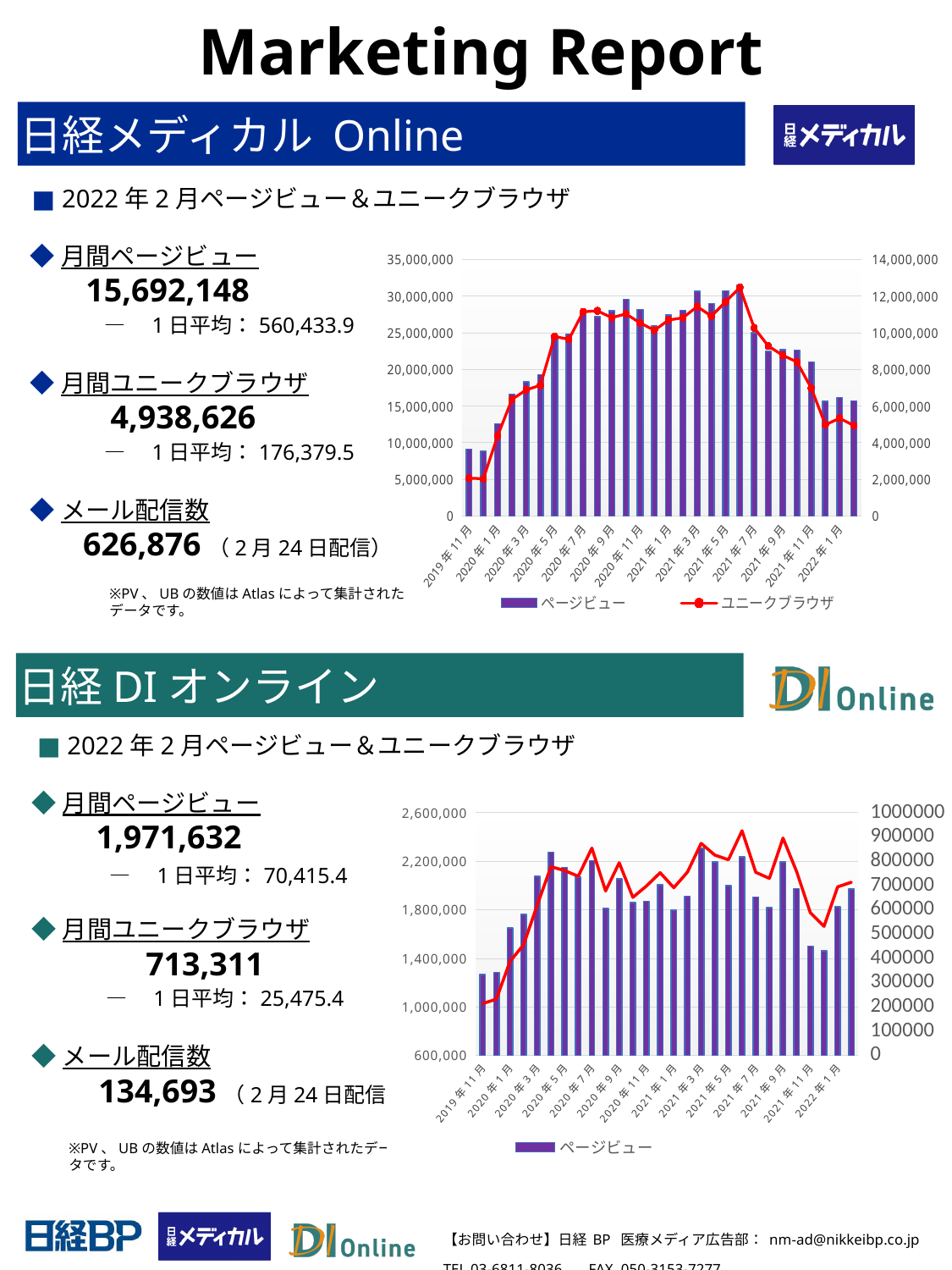
On the 日経 DI オンライン chart, is the ページビュー value for 2020年5月 greater or less than 2,000,000? greater On the 日経メディカル Online chart, what is the highest tick shown on the left vertical axis? 35,000,000 On the 日経メディカル Online chart, which month has the larger ページビュー value, 2021年3月 or 2022年1月? 2021年3月 What kind of chart is the 日経メディカル Online chart? bar chart with a line On the 日経メディカル Online chart, how many series does the legend list? 2 On the 日経メディカル Online chart, do the ページビュー bars rise or fall from 2021年7月 to 2022年1月? fall On the 日経 DI オンライン chart, how many series does the legend list? 1 On the 日経 DI オンライン chart, which month has the larger ページビュー value, 2020年5月 or 2021年11月? 2020年5月 On the 日経 DI オンライン chart, is the ページビュー value for 2019年11月 greater or less than 1,400,000? less On the 日経メディカル Online chart, is the ページビュー value for 2019年11月 greater or less than 10,000,000? less